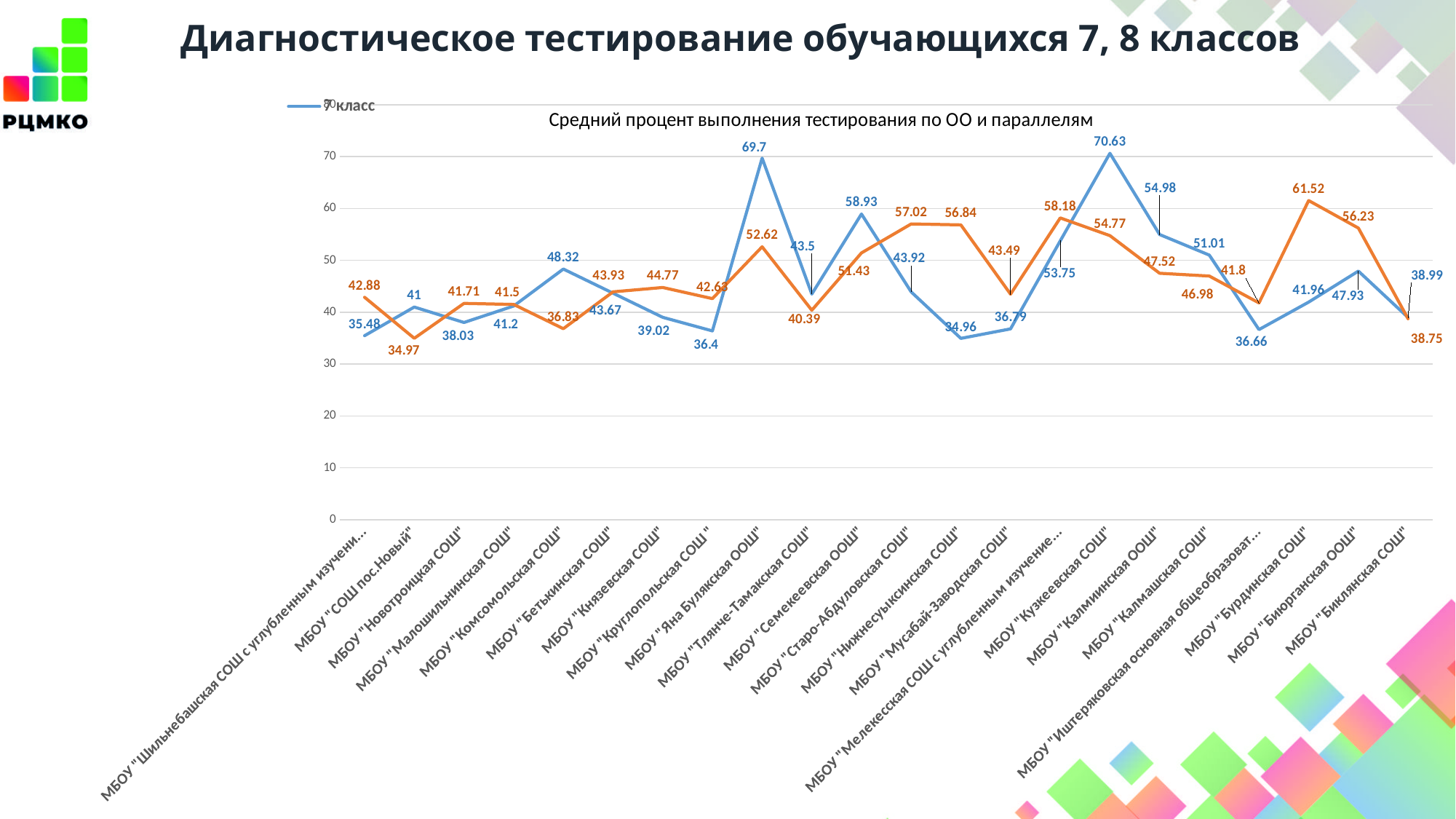
What is the difference between the blue and orange values for МБОУ "Яна Булякская ООШ"? 17.08 For which school does the blue line (7 класс) reach its highest value? МБОУ "Кузкеевская СОШ" What is the value of the blue line (7 класс) for МБОУ "Семекеевская ООШ"? 58.93 What type of chart is shown on the slide? line chart What is the value of the blue line (7 класс) for МБОУ "Кузкеевская СОШ"? 70.63 For МБОУ "Нижнесуыксинская СОШ", which line has the larger value, blue or orange? orange What is the value of the orange line for МБОУ "Бурдинская СОШ"? 61.52 What is the title of the chart? Средний процент выполнения тестирования по ОО и параллелям How many schools (categories) are plotted along the x axis? 22 For which school does the orange line have its lowest value? МБОУ "СОШ пос.Новый" For which school does the blue line (7 класс) have its lowest value? МБОУ "Нижнесуыксинская СОШ" For which school does the orange line reach its highest value? МБОУ "Бурдинская СОШ"